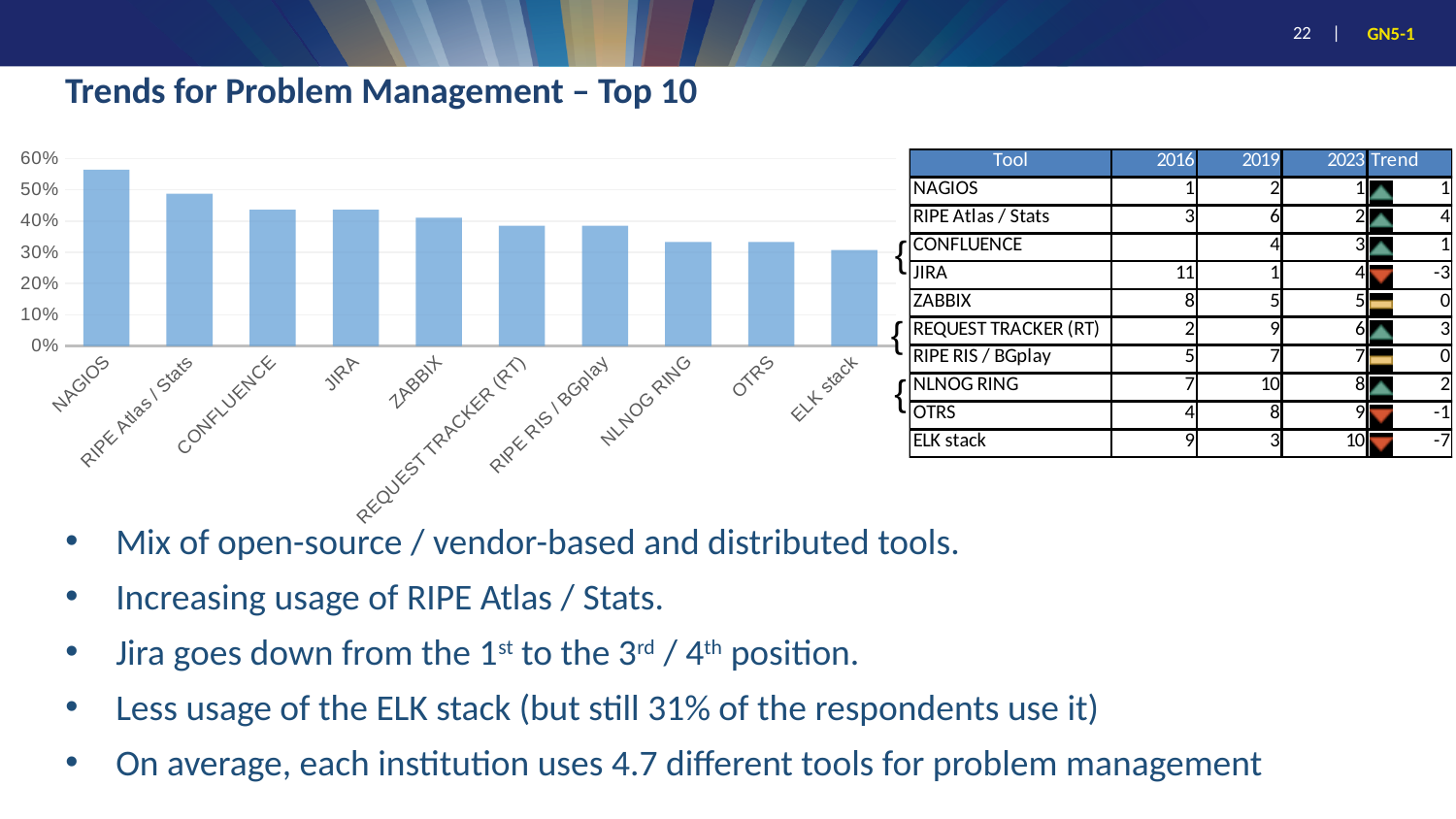
Which tool has the highest bar in the chart? NAGIOS Which has a larger value, NAGIOS or JIRA? NAGIOS Do the bar values rise or fall from left to right along the x axis? fall What kind of chart is shown on the slide? bar chart Which has a larger value, RIPE Atlas / Stats or ELK stack? RIPE Atlas / Stats Is the value for ZABBIX greater or less than 50%? less Is the value for ELK stack greater or less than 40%? less Is the value for NLNOG RING greater or less than 40%? less How many tools (categories) are plotted in the bar chart? 10 What is the highest value shown on the chart's y axis? 60%